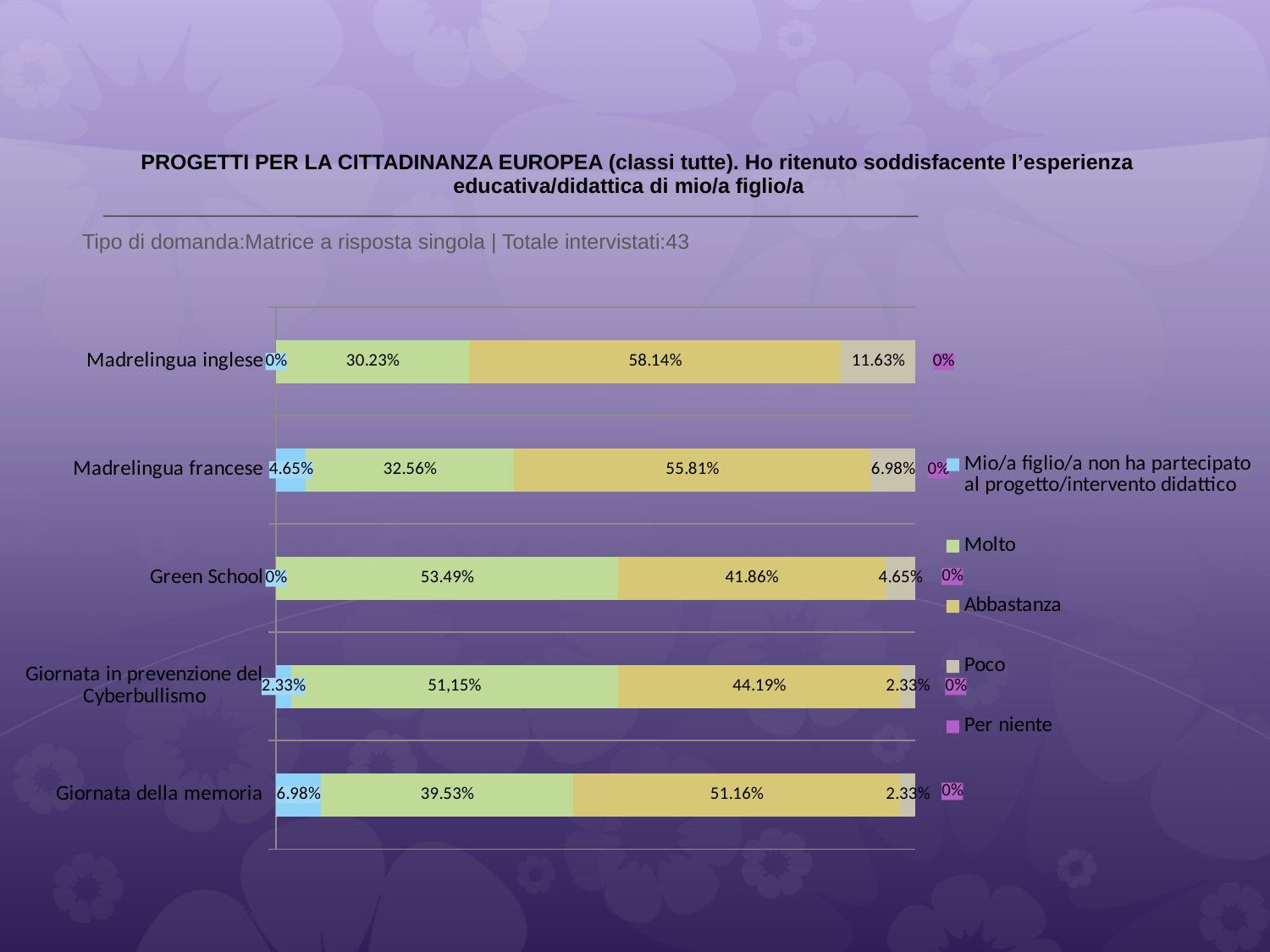
How many categories (projects) are plotted on the chart? 5 What is the 'Abbastanza' value for Madrelingua inglese? 58.14% Which project has the highest 'Molto' value? Green School Which is larger: the 'Abbastanza' value for Giornata della memoria or the 'Abbastanza' value for Giornata in prevenzione del Cyberbullismo? Giornata della memoria What is the 'Mio/a figlio/a non ha partecipato al progetto/intervento didattico' value for Giornata della memoria? 6.98% What is the 'Molto' value for Green School? 53.49% What is the difference between the 'Abbastanza' values for Madrelingua inglese and Green School? 16.28% How many series does the legend list? 5 Which project has the lowest 'Molto' value? Madrelingua inglese What kind of chart is shown on the slide? Stacked bar chart What is the 'Poco' value for Madrelingua francese? 6.98% Which project has the highest 'Poco' value? Madrelingua inglese